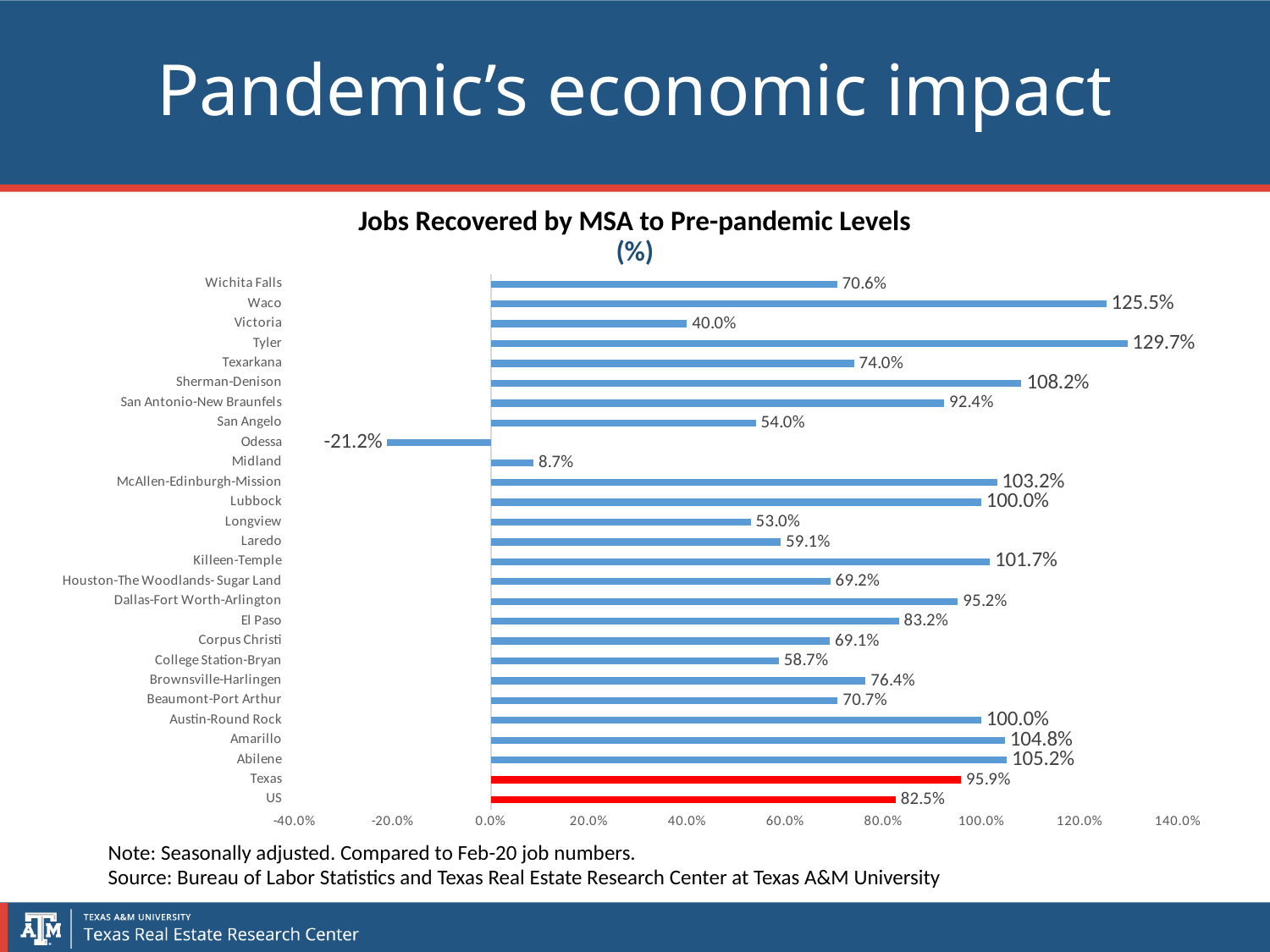
What is the value for Odessa? -21.2% What is the value for the US? 82.5% What is the difference between the values for Texas and the US? 13.4% Which has a larger value, Midland or Victoria? Victoria What is the value for Texas? 95.9% What kind of chart is shown on the slide? Bar chart What is the title of the chart? Jobs Recovered by MSA to Pre-pandemic Levels (%) How many categories (bars) are shown in the chart? 27 Which has a larger value, Waco or Wichita Falls? Waco What is the value for Tyler? 129.7% Which MSA has the highest jobs recovered value? Tyler Which MSA has the lowest jobs recovered value? Odessa